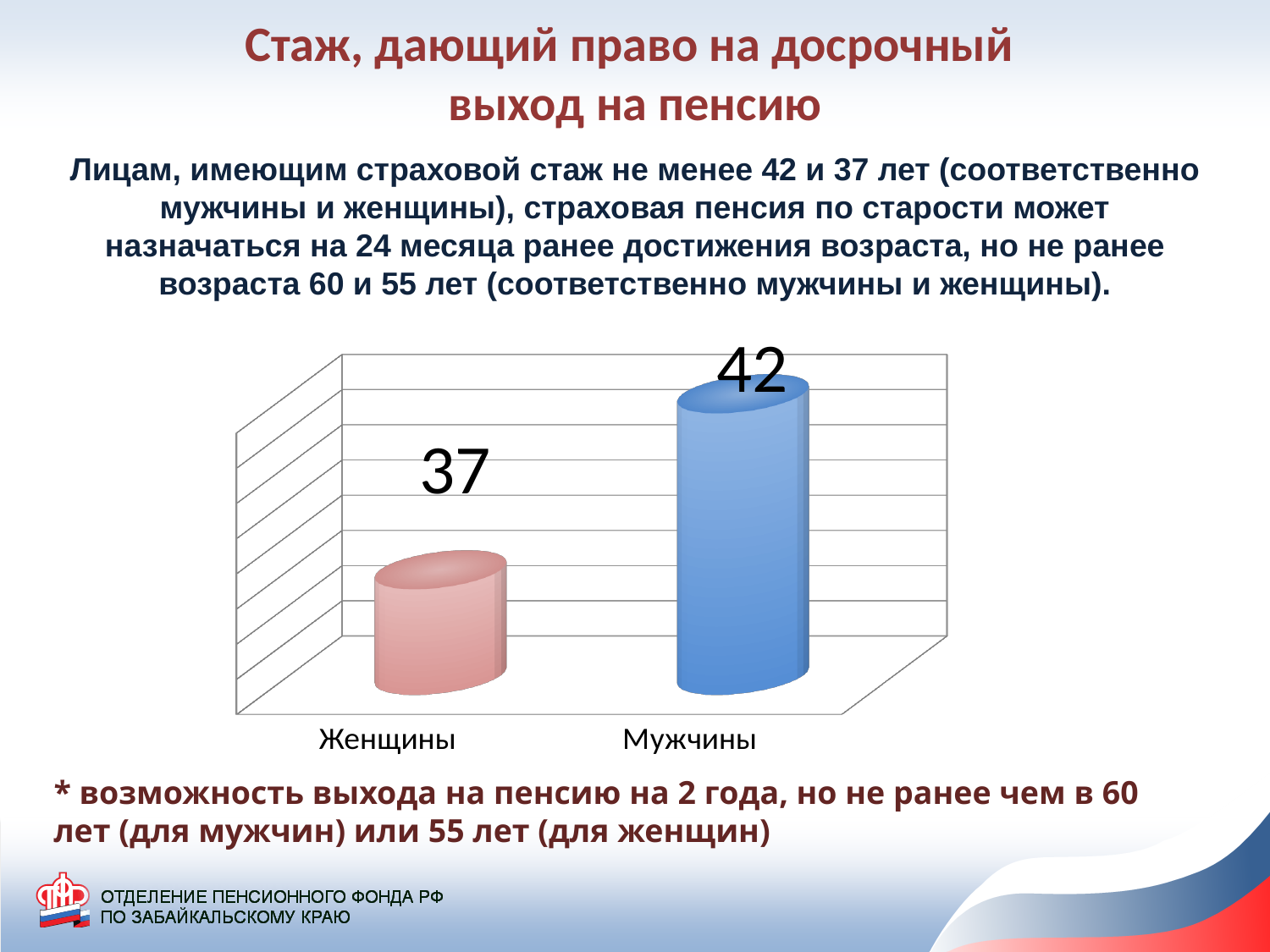
What colour is the bar for Мужчины? blue Do the values rise or fall from Женщины to Мужчины? rise What kind of chart is shown on the slide? bar chart What is the value shown for Женщины? 37 What is the difference between the values for Мужчины and Женщины? 5 Which category has the highest value? Мужчины Which category has the lowest value? Женщины What is the value shown for Мужчины? 42 Which is larger, the value for Женщины or the value for Мужчины? Мужчины What colour is the bar for Женщины? pink How many categories are shown in the chart? 2